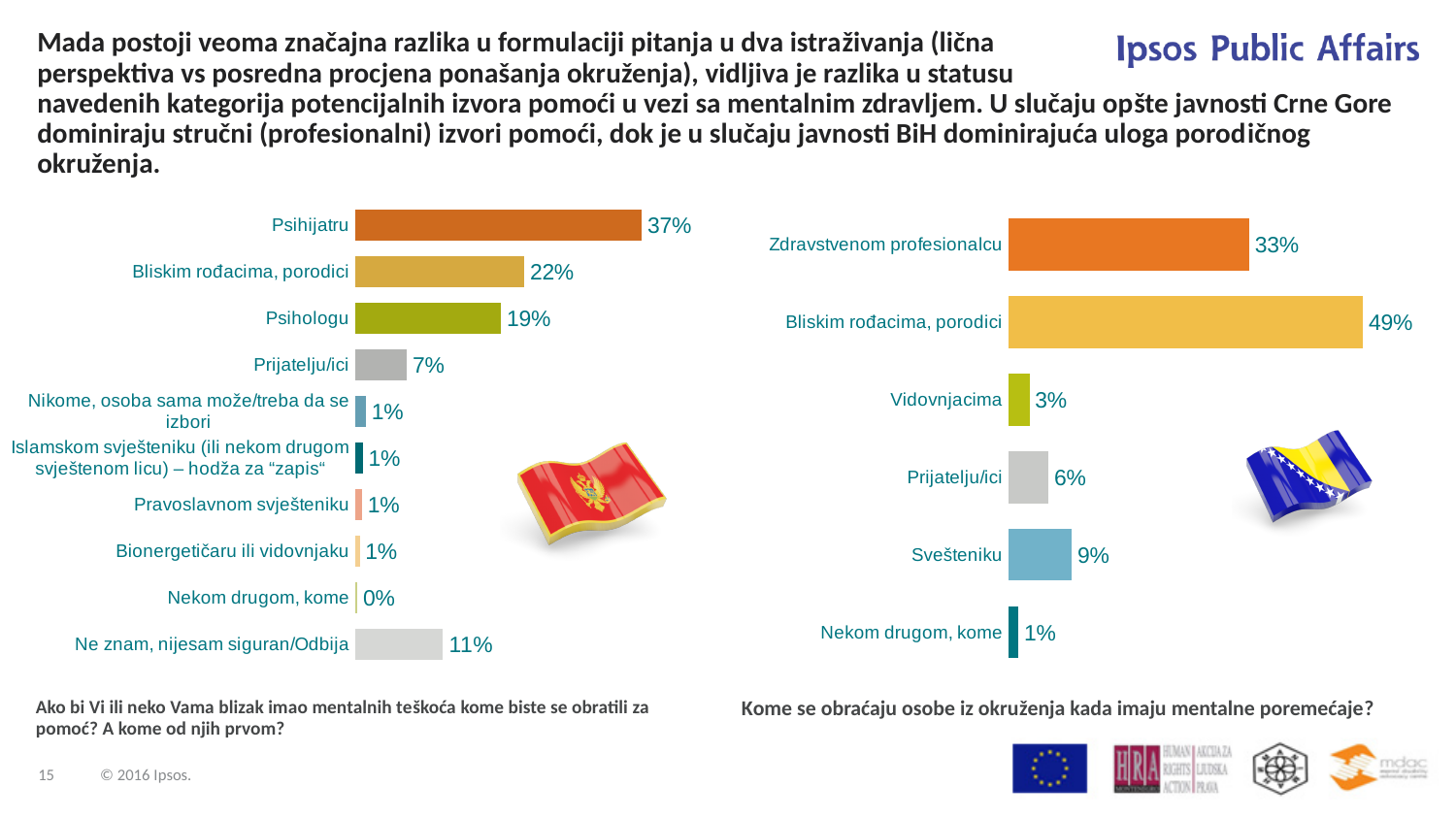
In the right chart, what is the value for Svešteniku? 9% In the right chart, what is the value for Bliskim rođacima, porodici? 49% How many categories does the right chart show? 6 In the left chart, which category has the highest value? Psihijatru In the left chart, which category has the lowest value? Nekom drugom, kome In the right chart, which category has the lowest value? Nekom drugom, kome In the left chart, which is larger: Bliskim rođacima, porodici or Psihologu? Bliskim rođacima, porodici In the right chart, what is the difference between Bliskim rođacima, porodici and Zdravstvenom profesionalcu? 16% In the left chart, what is the value for Ne znam, nijesam siguran/Odbija? 11% What type of chart is the left chart? Bar chart In the left chart, what is the difference between Psihijatru and Psihologu? 18% In the left chart, what is the value for Psihijatru? 37%